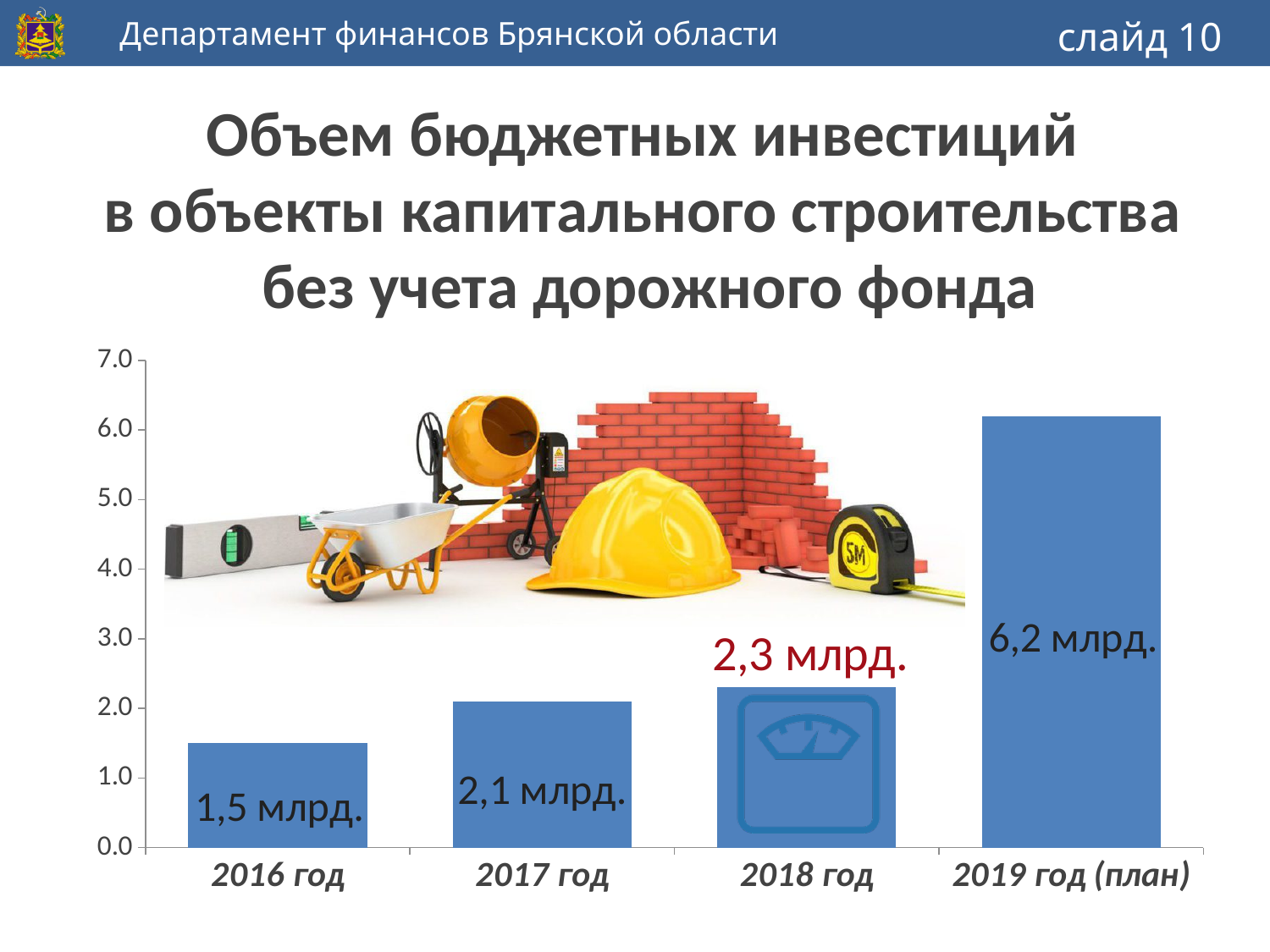
How many years are shown on the x axis? 4 What is the difference between the values for 2019 год (план) and 2018 год? 3,9 млрд. Which is larger, the value for 2017 год or the value for 2016 год? 2017 год What kind of chart is shown on the slide? bar chart What is the value for 2018 год? 2,3 млрд. What is the value for 2017 год? 2,1 млрд. What is the difference between the values for 2017 год and 2016 год? 0,6 млрд. Which year has the lowest value? 2016 год What is the value for 2016 год? 1,5 млрд. Which year has the highest value? 2019 год (план) What is the value for 2019 год (план)? 6,2 млрд. Do the values rise or fall from 2016 год to 2019 год (план)? rise